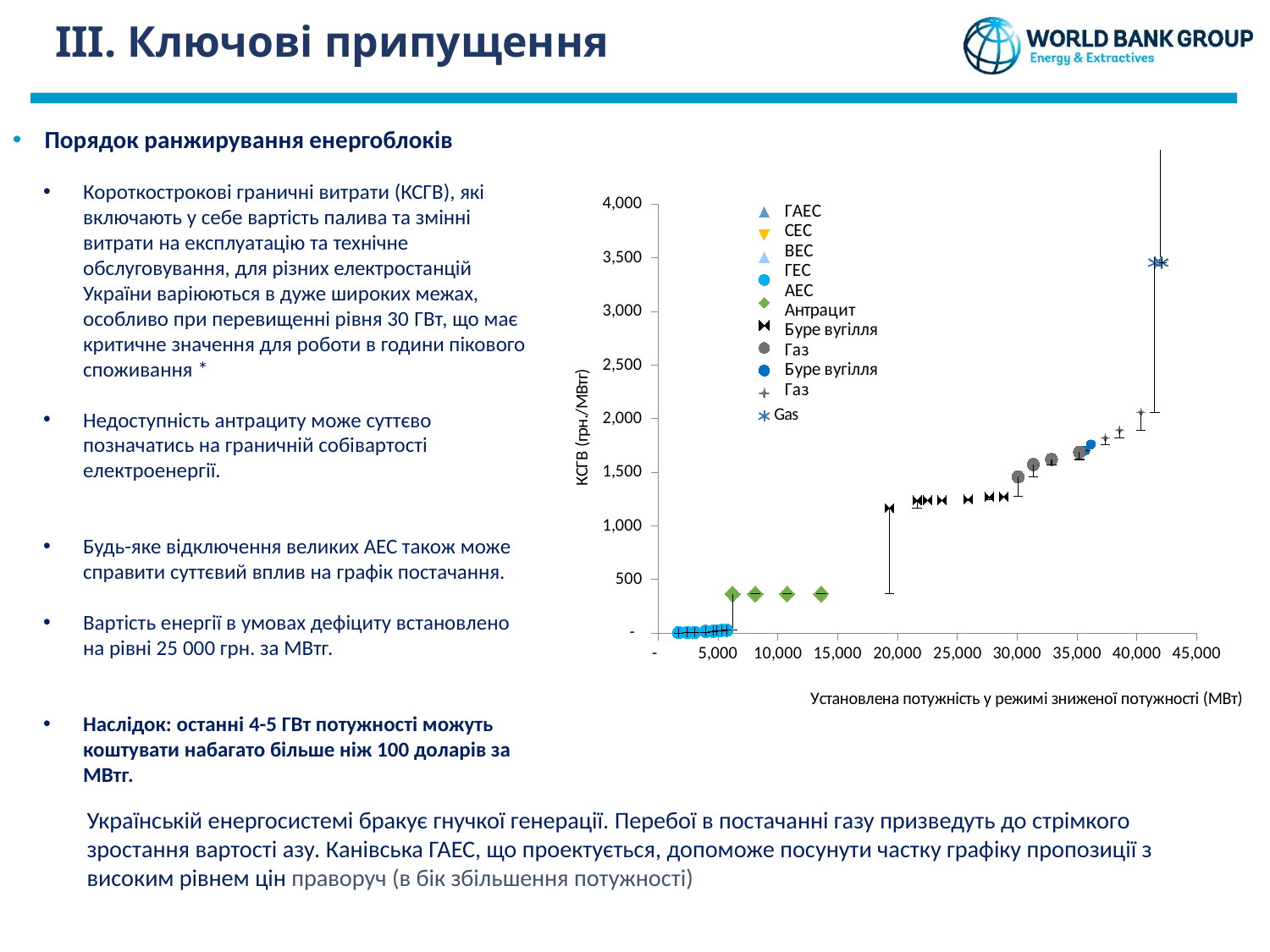
Are the values for the Буре вугілля points (black markers) greater or less than 1,000? greater Which series has the highest plotted value on the chart? Gas What is the label of the vertical axis of the chart? КСГВ (грн./МВтг) Are the values for the Антрацит points greater or less than 500? less What kind of chart is shown on the slide? scatter chart Do the plotted values rise or fall as installed capacity increases along the x axis? rise How many series does the chart legend list? 11 What is the highest tick value shown on the vertical axis? 4,000 Is the value for the Gas (asterisk) point at the far right greater or less than 3,000? greater Which is larger: the value of the Антрацит points or the value of the Буре вугілля points? Буре вугілля What is the label of the horizontal axis of the chart? Установлена потужність у режимі зниженої потужності (МВт)